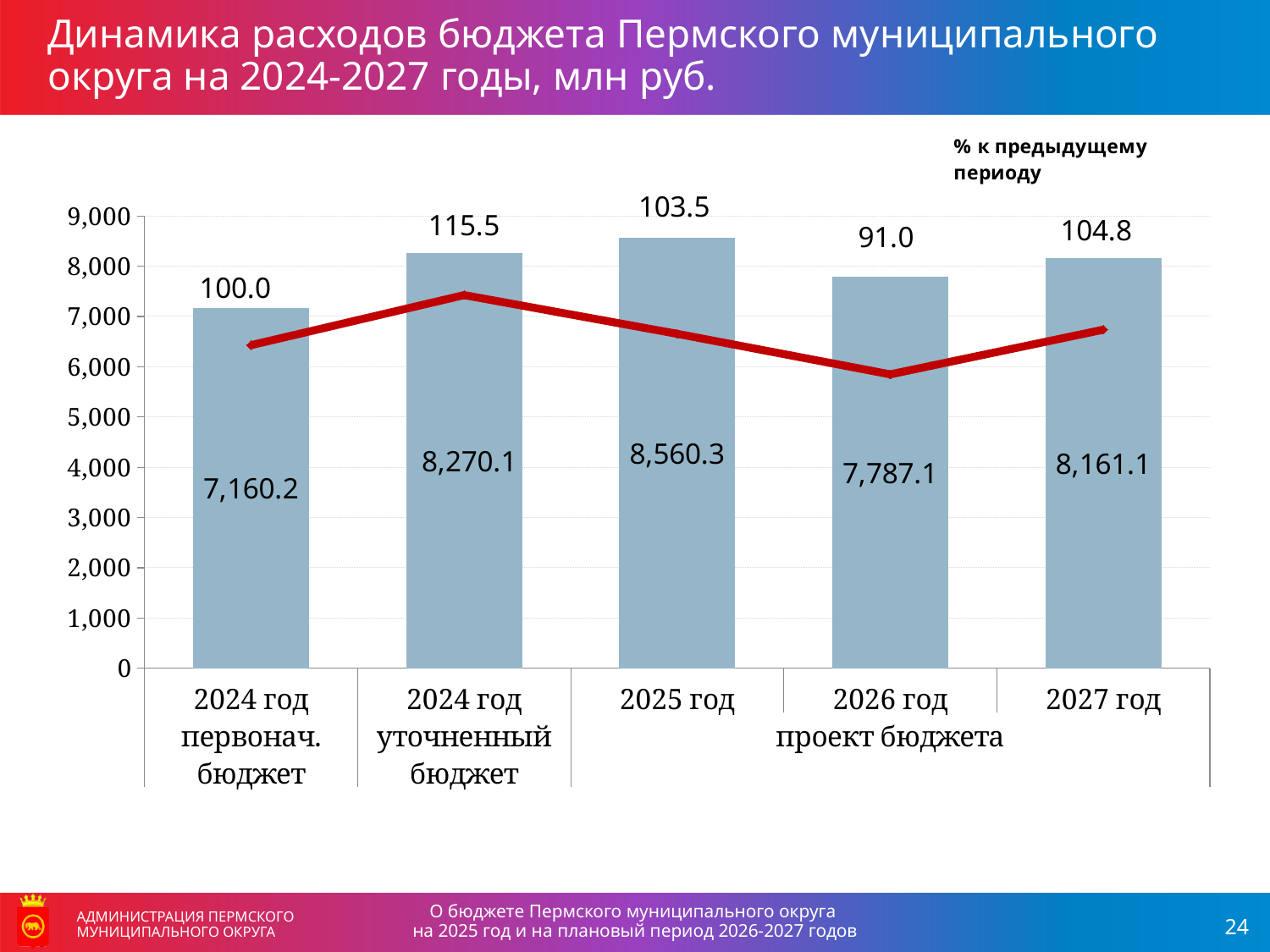
What is the budget expenditure value shown for 2025 год? 8,560.3 Is the budget expenditure bar for 2026 год greater or less than 8,000? less What is the budget expenditure value shown for 2024 год первонач. бюджет? 7,160.2 What is the '% к предыдущему периоду' value shown for 2024 год уточненный бюджет? 115.5 Which category has the highest budget expenditure bar? 2025 год What is the '% к предыдущему периоду' value shown for 2026 год? 91.0 What kind of chart is shown on the slide? Combined bar and line chart Which category has the lowest budget expenditure bar? 2024 год первонач. бюджет How many categories are shown on the x axis of the chart? 5 What is the difference between the budget expenditure for 2025 год and for 2024 год первонач. бюджет? 1,400.1 What is the difference between the budget expenditure for 2024 год уточненный бюджет and for 2026 год? 483.0 Which is larger: the budget expenditure for 2027 год or for 2026 год? 2027 год